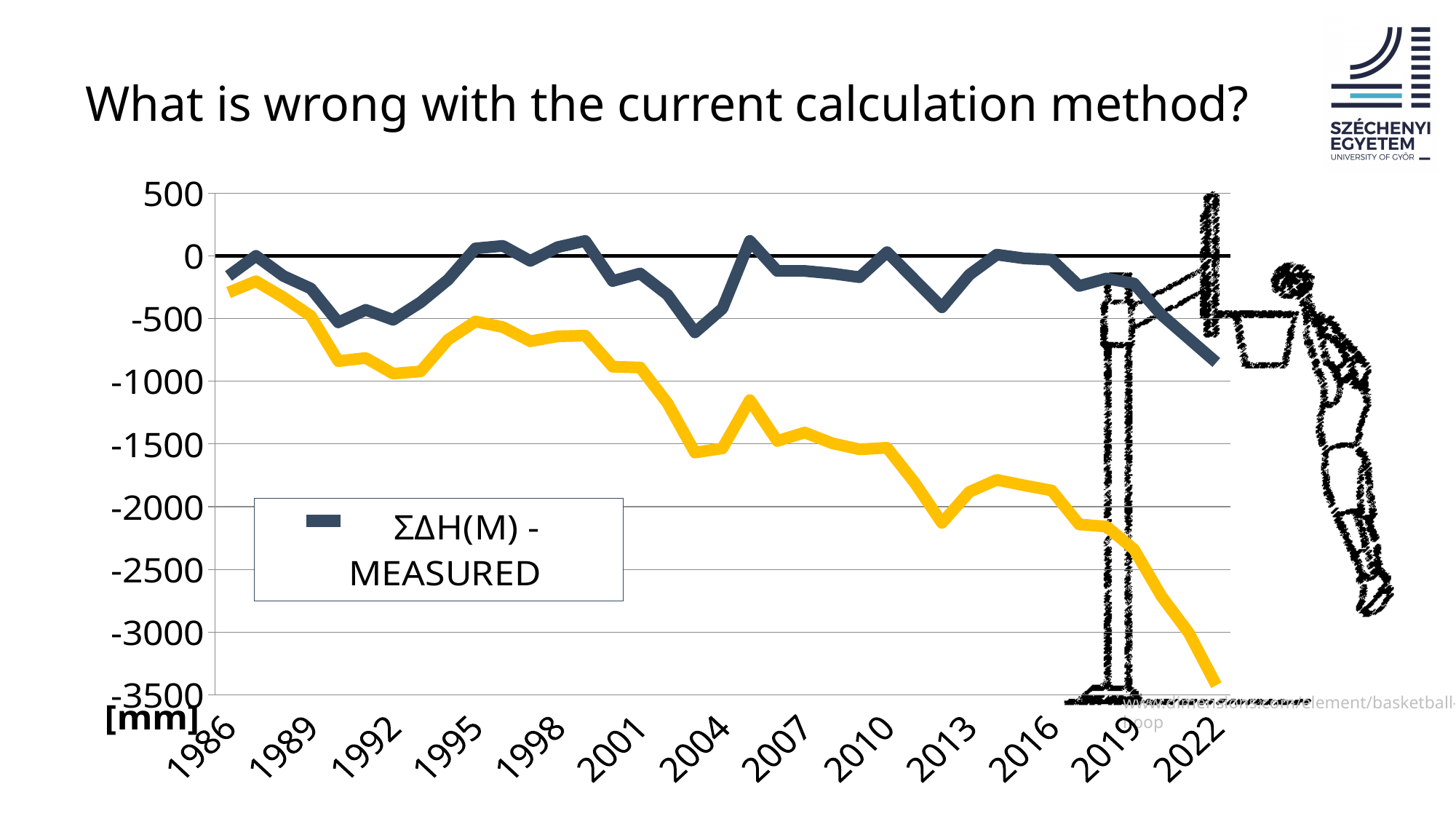
Is the value of the yellow line at 2013 greater or less than -2000? greater What kind of chart is shown on the slide? line chart How many series entries does the legend list? 1 What unit is shown for the vertical axis? [mm] Is the value of the ΣΔH(M) - MEASURED line at 2022 greater or less than -1000? greater Is the value of the ΣΔH(M) - MEASURED line at 2022 greater or less than -500? less At 2022, which line has the higher value, the ΣΔH(M) - MEASURED line or the yellow line? ΣΔH(M) - MEASURED Overall, does the yellow line rise or fall from 1986 to 2022? fall What series name does the legend list? ΣΔH(M) - MEASURED How many lines are plotted on the chart? 2